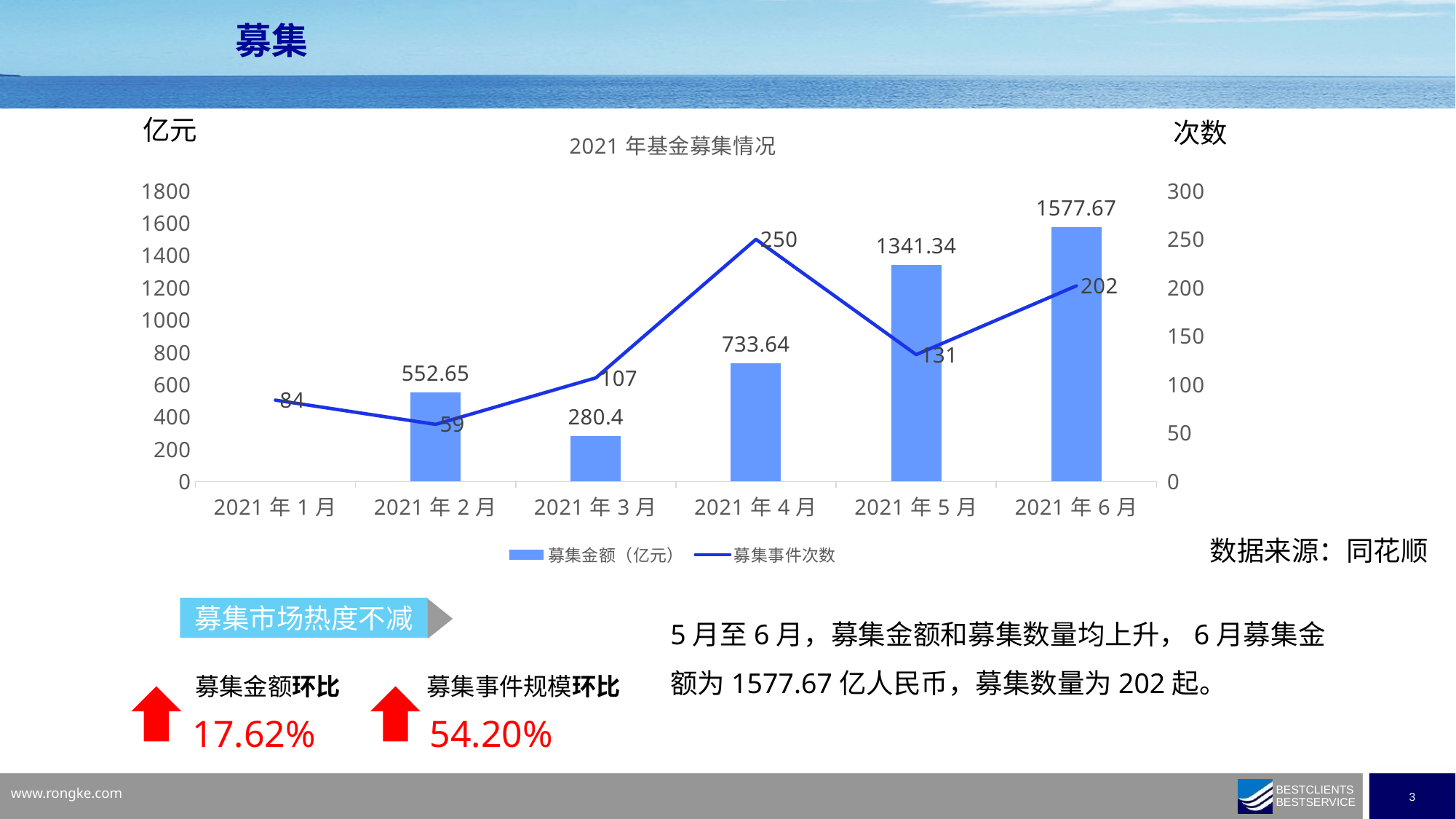
What is the 募集金额 (亿元) for 2021 年 6 月? 1577.67 What is the difference in 募集事件次数 between 2021 年 6 月 and 2021 年 5 月? 71 Which month has the highest 募集事件次数? 2021 年 4 月 What is the 募集事件次数 for 2021 年 4 月? 250 Which is larger, the 募集金额 for 2021 年 4 月 or for 2021 年 2 月? 2021 年 4 月 What is the title of the chart? 2021 年基金募集情况 How many series does the chart legend list? 2 How many months are shown on the x axis of the chart? 6 Which month has the lowest 募集事件次数? 2021 年 2 月 Which month has the highest 募集金额 (亿元)? 2021 年 6 月 What is the 募集事件次数 for 2021 年 2 月? 59 What is the 募集金额 (亿元) for 2021 年 3 月? 280.4